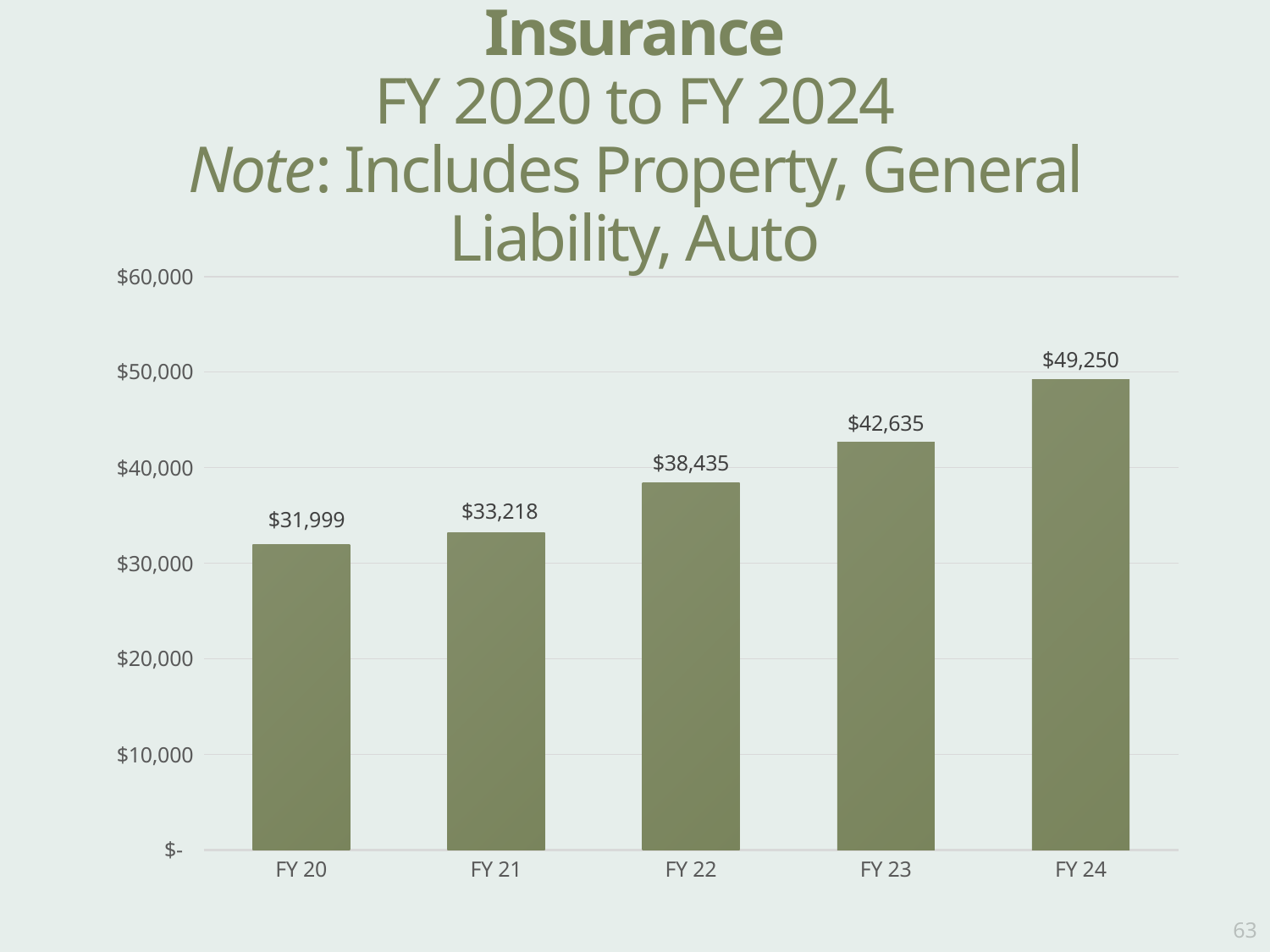
What is the insurance value for FY 20? $31,999 Which fiscal year has the lowest insurance value? FY 20 Which is larger, the insurance value for FY 22 or FY 23? FY 23 What kind of chart is shown on the slide? bar chart Do the insurance values rise or fall from FY 20 to FY 24? rise How many fiscal years are shown on the chart? 5 What is the insurance value for FY 24? $49,250 Which fiscal year has the highest insurance value? FY 24 What is the insurance value for FY 22? $38,435 Is the value for FY 23 greater or less than $40,000? greater What is the difference between the FY 24 and FY 23 insurance values? $6,615 What is the difference between the FY 21 and FY 20 insurance values? $1,219